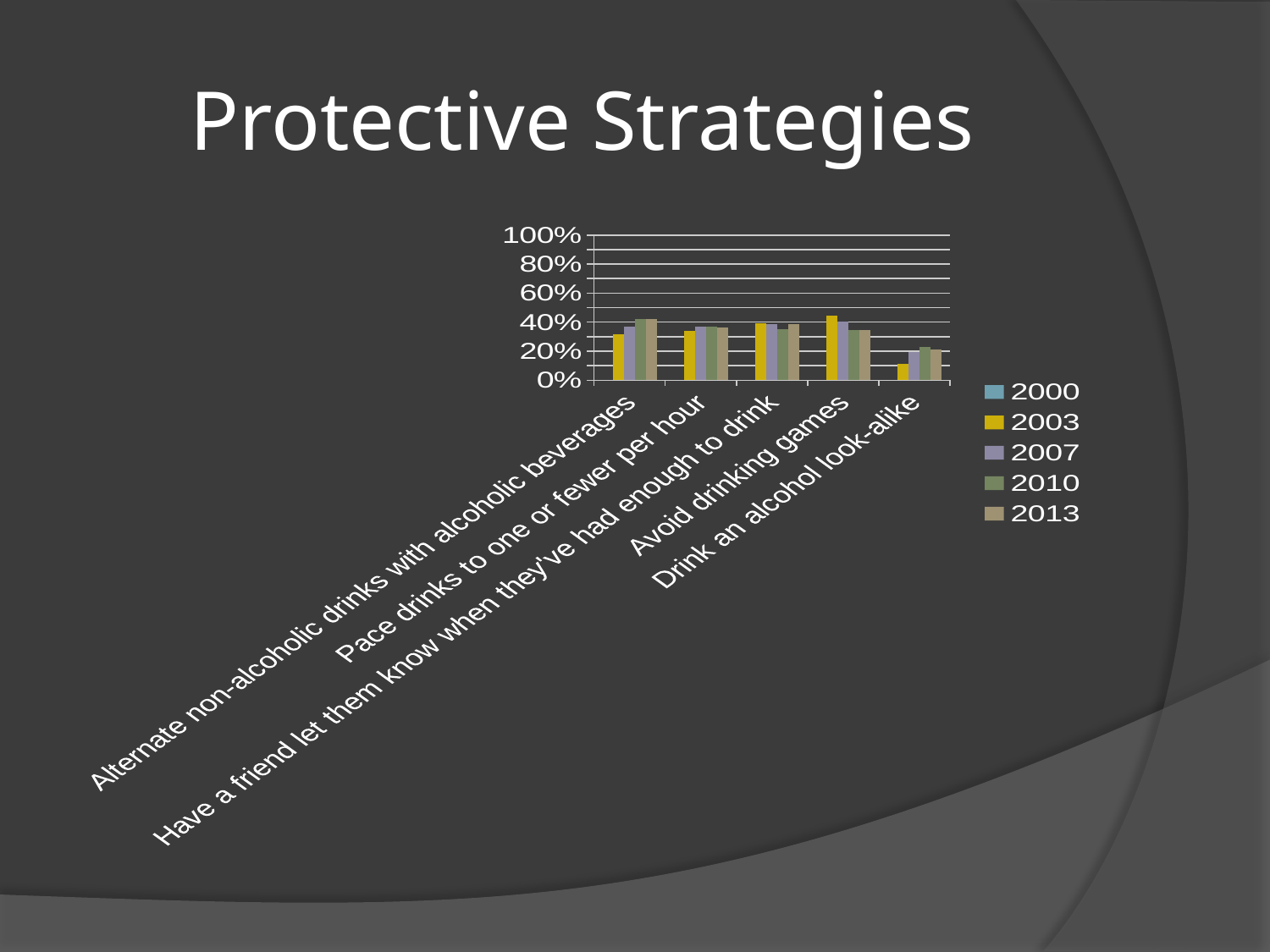
Is the 2003 value for 'Avoid drinking games' greater or less than 40%? greater Is any bar in the chart greater than 60%? No For 'Drink an alcohol look-alike', do the values rise or fall from 2003 to 2010? rise Which years are listed in the legend? 2000, 2003, 2007, 2010, 2013 Is the 2003 value for 'Drink an alcohol look-alike' greater or less than 20%? less What kind of chart is shown on the slide? bar chart For 2003, which is larger: 'Avoid drinking games' or 'Drink an alcohol look-alike'? Avoid drinking games How many series does the legend list? 5 Which category has the lowest values across the years? Drink an alcohol look-alike What is the title of the slide containing the chart? Protective Strategies How many categories are shown on the x axis? 5